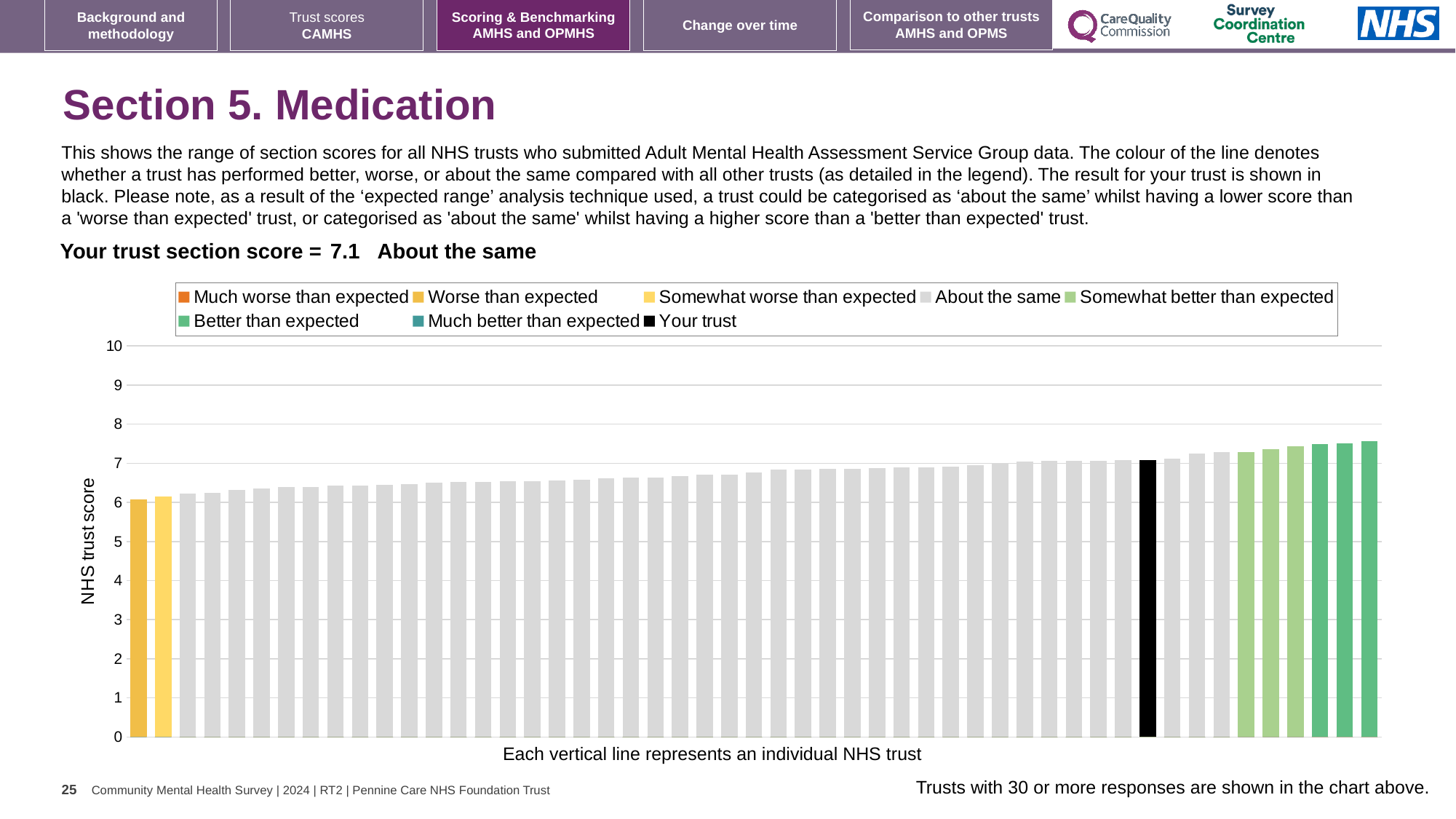
What colour is the bar representing your trust? Black Is the value of the leftmost bar greater or less than 5? greater What kind of chart is shown on the slide? Bar chart Is the value for your trust (the black bar) greater or less than 5? greater Is the highest bar in the chart higher or lower than your trust's black bar? higher What is the section score for your trust shown on the slide? 7.1 Is the value of the rightmost bar greater or less than 8? less Which is larger, the leftmost bar or the rightmost bar? the rightmost bar What is the label on the y axis of the chart? NHS trust score Which category is your trust's section score placed in? About the same How many entries does the chart legend list? 8 Do the bar values rise or fall from left to right along the x axis? rise